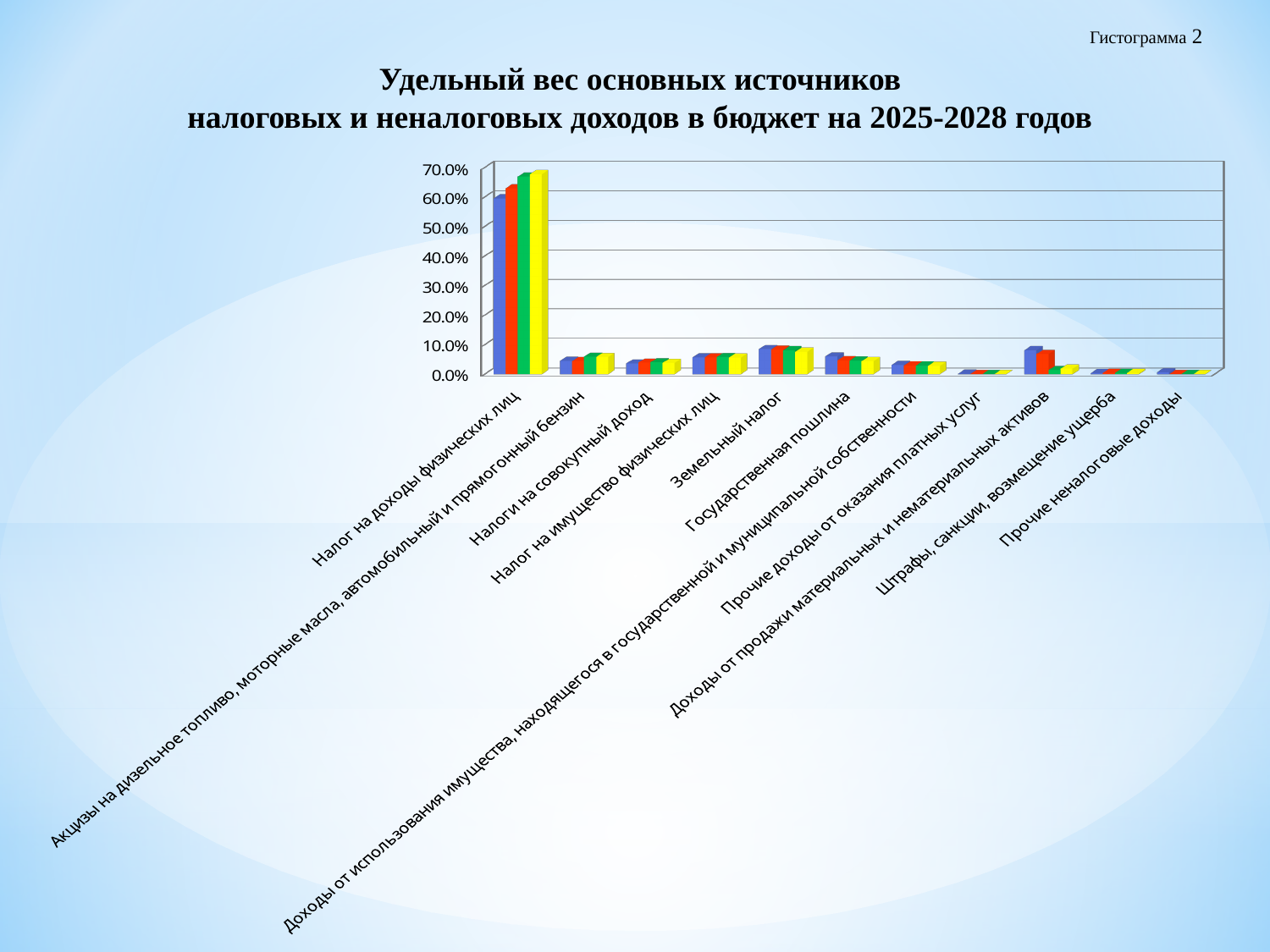
What is the title of the chart on the slide? Удельный вес основных источников налоговых и неналоговых доходов в бюджет на 2025-2028 годов Which is larger, the value for Земельный налог or the value for Налоги на совокупный доход? Земельный налог Which category has the highest bars in the chart? Налог на доходы физических лиц How many categories are shown on the x axis of the chart? 11 Is the value for Земельный налог greater or less than 20.0%? less Which is larger, the value for Налог на доходы физических лиц or the value for Земельный налог? Налог на доходы физических лиц Which is larger, the value for Государственная пошлина or the value for Прочие доходы от оказания платных услуг? Государственная пошлина Is the value for Налог на доходы физических лиц greater or less than 50.0%? greater Is the value for Прочие доходы от оказания платных услуг greater or less than 10.0%? less What is the highest value shown on the vertical axis of the chart? 70.0% What kind of chart is shown on the slide? bar chart